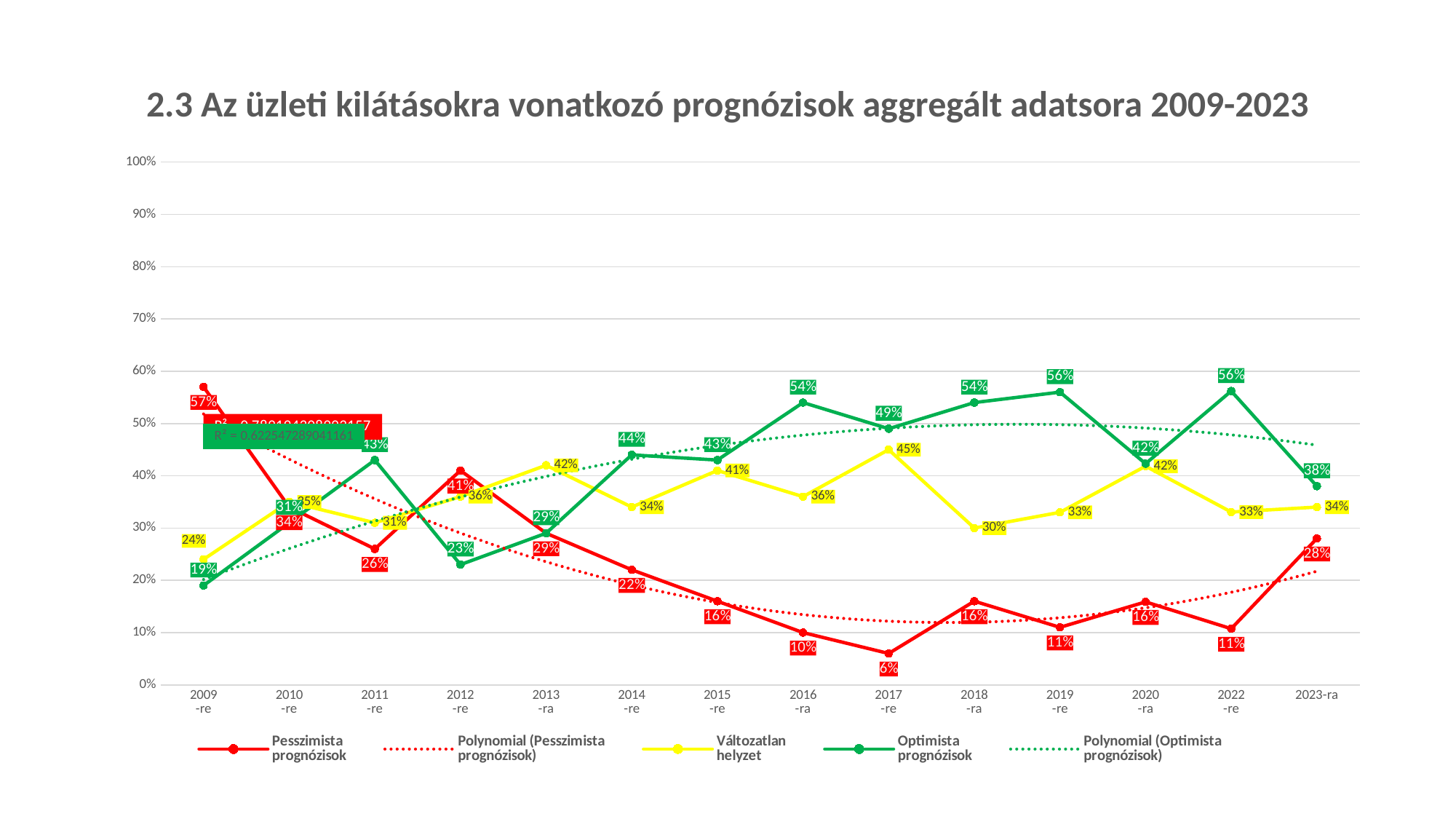
For 2012-re, which is larger: Pesszimista prognózisok or Optimista prognózisok? Pesszimista prognózisok What is the value of Változatlan helyzet for 2017-re? 45% What colour is the Optimista prognózisok line? Green In which year does Pesszimista prognózisok reach its lowest value? 2017-re Does Pesszimista prognózisok generally rise or fall from 2009-re to 2017-re? Fall What kind of chart is shown on the slide? Line chart In which year does Változatlan helyzet reach its highest value? 2017-re What is the value of Pesszimista prognózisok for 2009-re? 57% What is the difference between Optimista prognózisok and Pesszimista prognózisok for 2016-ra? 44 percentage points How many years are shown on the x axis? 14 How many entries does the legend list? 5 What is the value of Optimista prognózisok for 2019-re? 56%